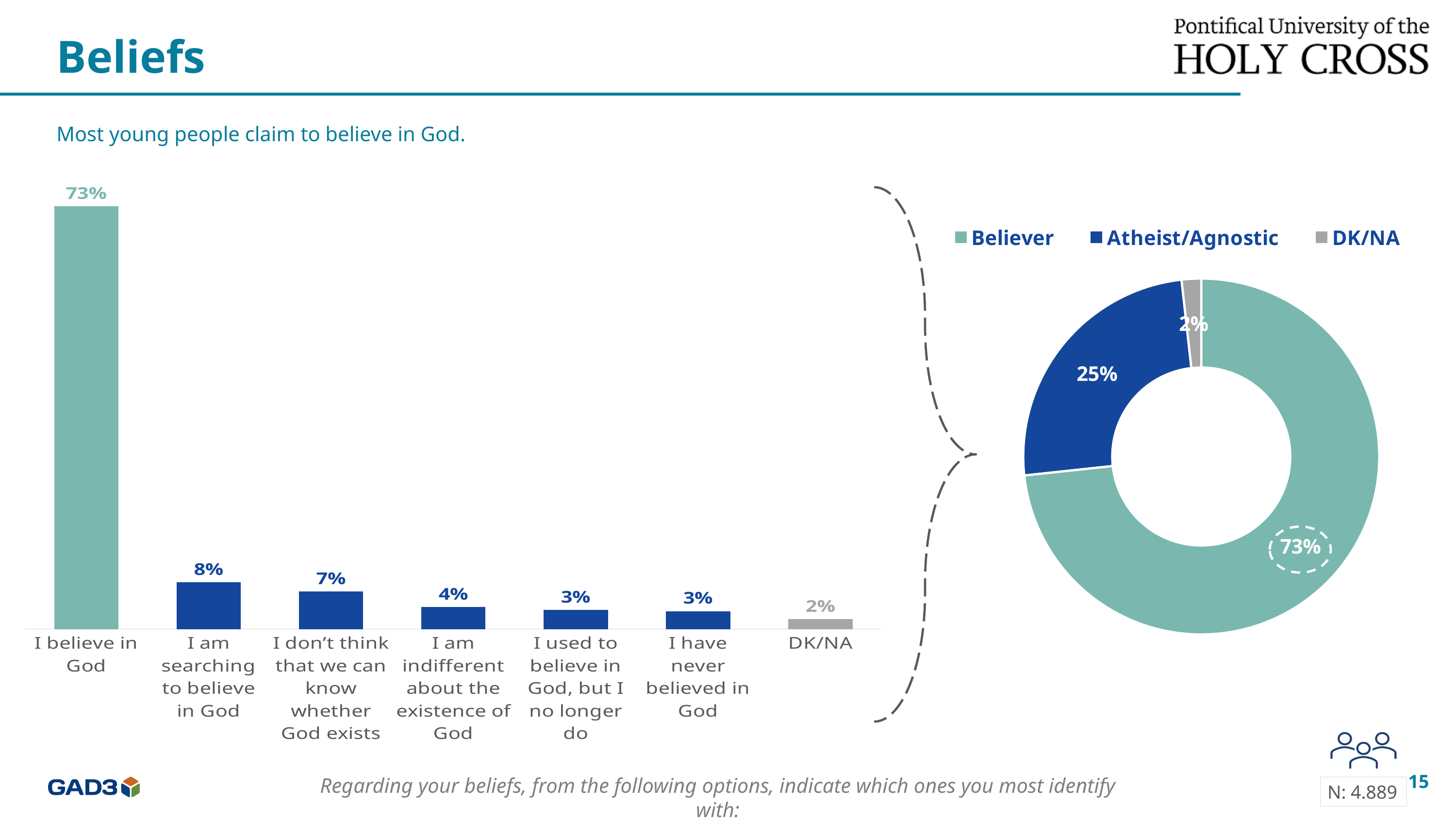
In the donut chart on the right, what share is Atheist/Agnostic? 25% In the bar chart on the left, which category has the lowest value? DK/NA In the bar chart on the left, what is the value for "I believe in God"? 73% How many entries does the legend of the donut chart on the right list? 3 In the bar chart on the left, which category has the highest value? I believe in God In the bar chart on the left, what is the value for "I am indifferent about the existence of God"? 4% In the donut chart on the right, what share is Believer? 73% In the bar chart on the left, which is larger: "I am searching to believe in God" or "I don't think that we can know whether God exists"? I am searching to believe in God How many categories does the bar chart on the left show? 7 What kind of chart is on the left of the slide? Bar chart In the bar chart on the left, what is the value for "I am searching to believe in God"? 8% In the bar chart on the left, what is the difference between "I believe in God" and "I am searching to believe in God"? 65 percentage points